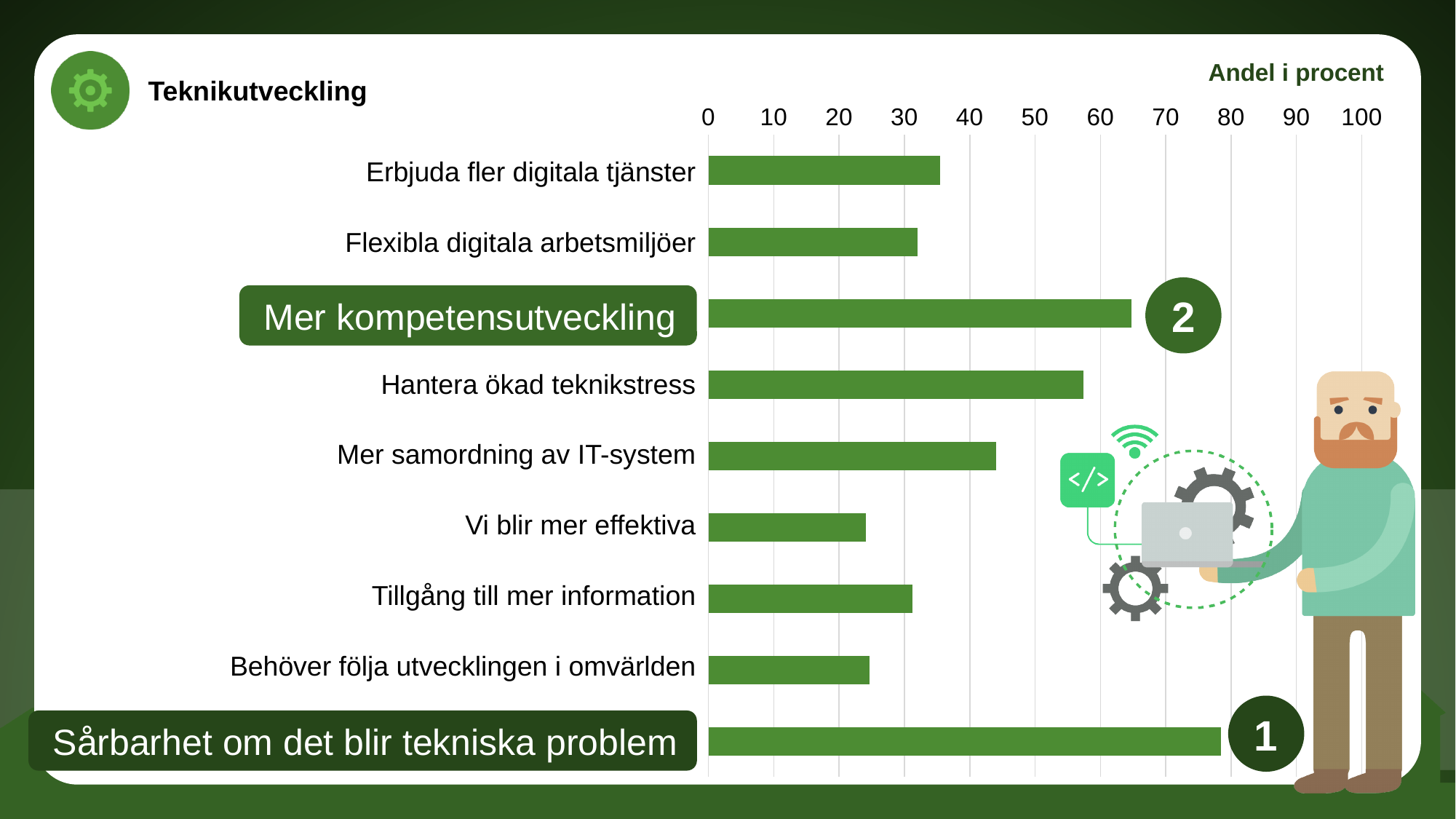
Is the value for Mer samordning av IT-system greater or less than 50? less What is the label shown above the chart's horizontal axis? Andel i procent Which category has the highest value in the chart? Sårbarhet om det blir tekniska problem Which is larger: the value for Mer kompetensutveckling or the value for Hantera ökad teknikstress? Mer kompetensutveckling Which is larger: the value for Erbjuda fler digitala tjänster or the value for Vi blir mer effektiva? Erbjuda fler digitala tjänster What kind of chart is shown on the slide? bar chart Is the value for Vi blir mer effektiva greater or less than 30? less Is the value for Mer kompetensutveckling greater or less than 60? greater Which category is marked with the number 2 on the slide? Mer kompetensutveckling How many categories are plotted in the chart? 9